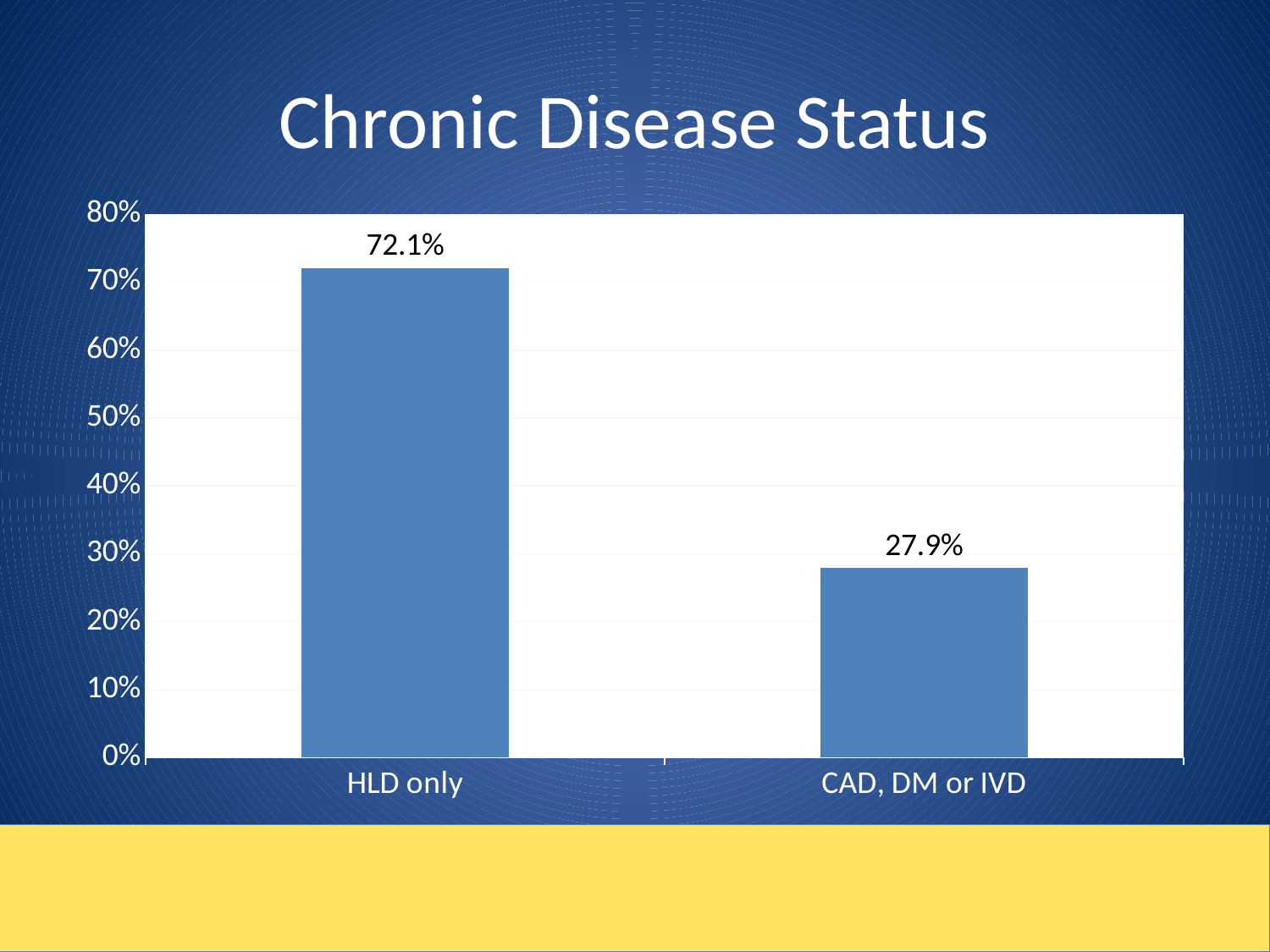
What is the difference between the values for HLD only and CAD, DM or IVD? 44.2% What is the maximum value shown on the y axis? 80% Which category has the highest value? HLD only How many categories are shown on the x axis? 2 What is the value for HLD only? 72.1% What is the title of the chart? Chronic Disease Status Is the value for CAD, DM or IVD greater or less than 30%? less Is the value for HLD only greater or less than 70%? greater What is the value for CAD, DM or IVD? 27.9% Which category has the lowest value? CAD, DM or IVD Which is larger, the value for HLD only or the value for CAD, DM or IVD? HLD only What kind of chart is shown on the slide? bar chart